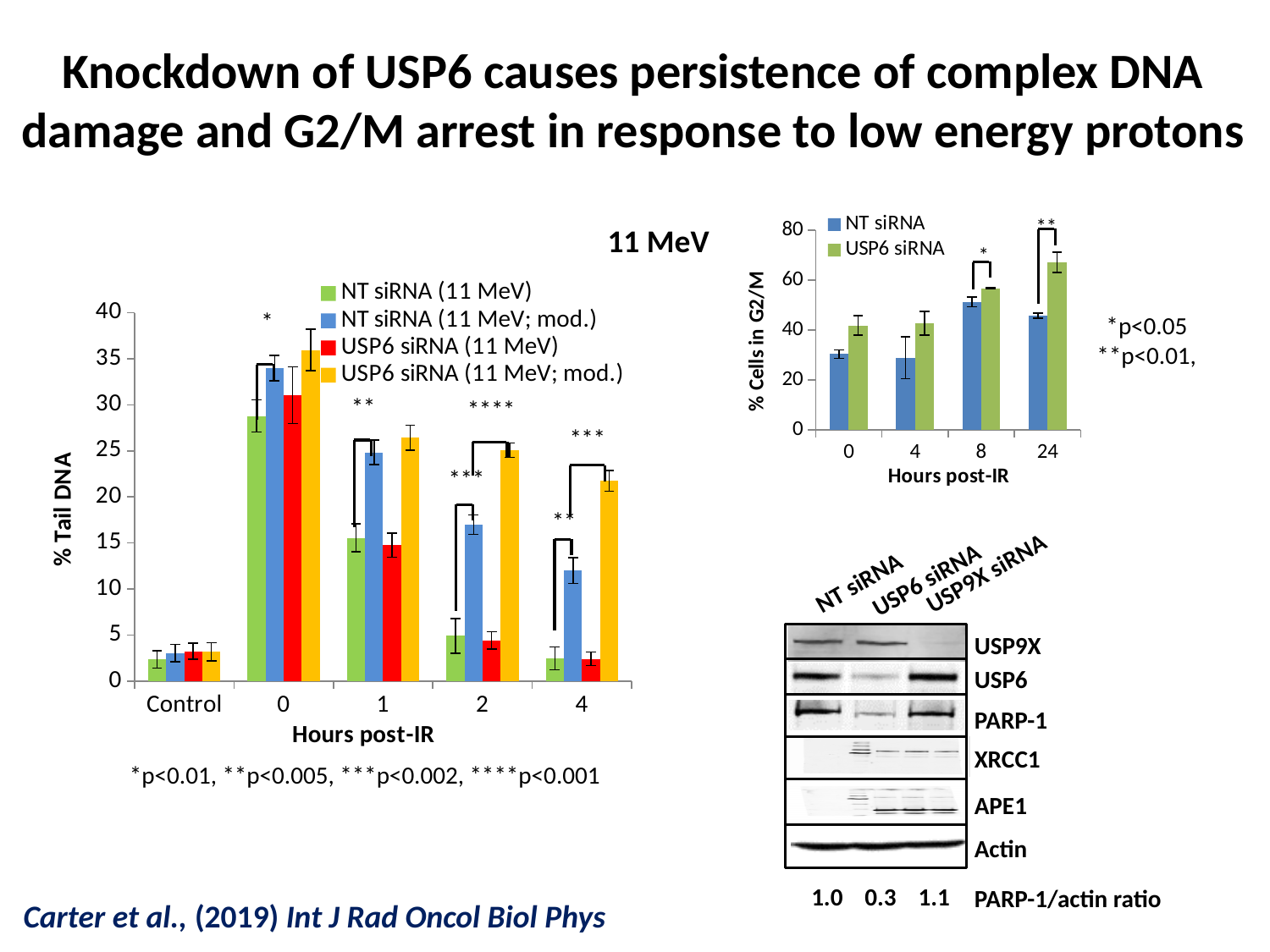
In the % Tail DNA chart on the left, at 4 hours post-IR, which is larger: NT siRNA (11 MeV; mod.) or USP6 siRNA (11 MeV; mod.)? USP6 siRNA (11 MeV; mod.) What kind of chart is the % Tail DNA chart on the left of the slide? bar chart In the % Cells in G2/M chart on the right, how many series does the legend list? 2 In the % Tail DNA chart on the left, do the NT siRNA (11 MeV) values rise or fall from 0 to 4 hours post-IR? fall In the % Tail DNA chart on the left, how many categories are shown on the x axis? 5 In the % Cells in G2/M chart on the right, is the value for USP6 siRNA at 24 hours post-IR greater or less than 60? greater In the % Tail DNA chart on the left, how many series does the legend list? 4 In the % Cells in G2/M chart on the right, how many hours post-IR categories are shown? 4 What is the y-axis title of the bar chart on the left of the slide? % Tail DNA In the % Tail DNA chart on the left, is the value for USP6 siRNA (11 MeV; mod.) at 4 hours post-IR greater or less than 20? greater In the % Cells in G2/M chart on the right, at which hours post-IR is the USP6 siRNA value highest? 24 In the % Tail DNA chart on the left, is the value for NT siRNA (11 MeV) at 2 hours post-IR greater or less than 10? less